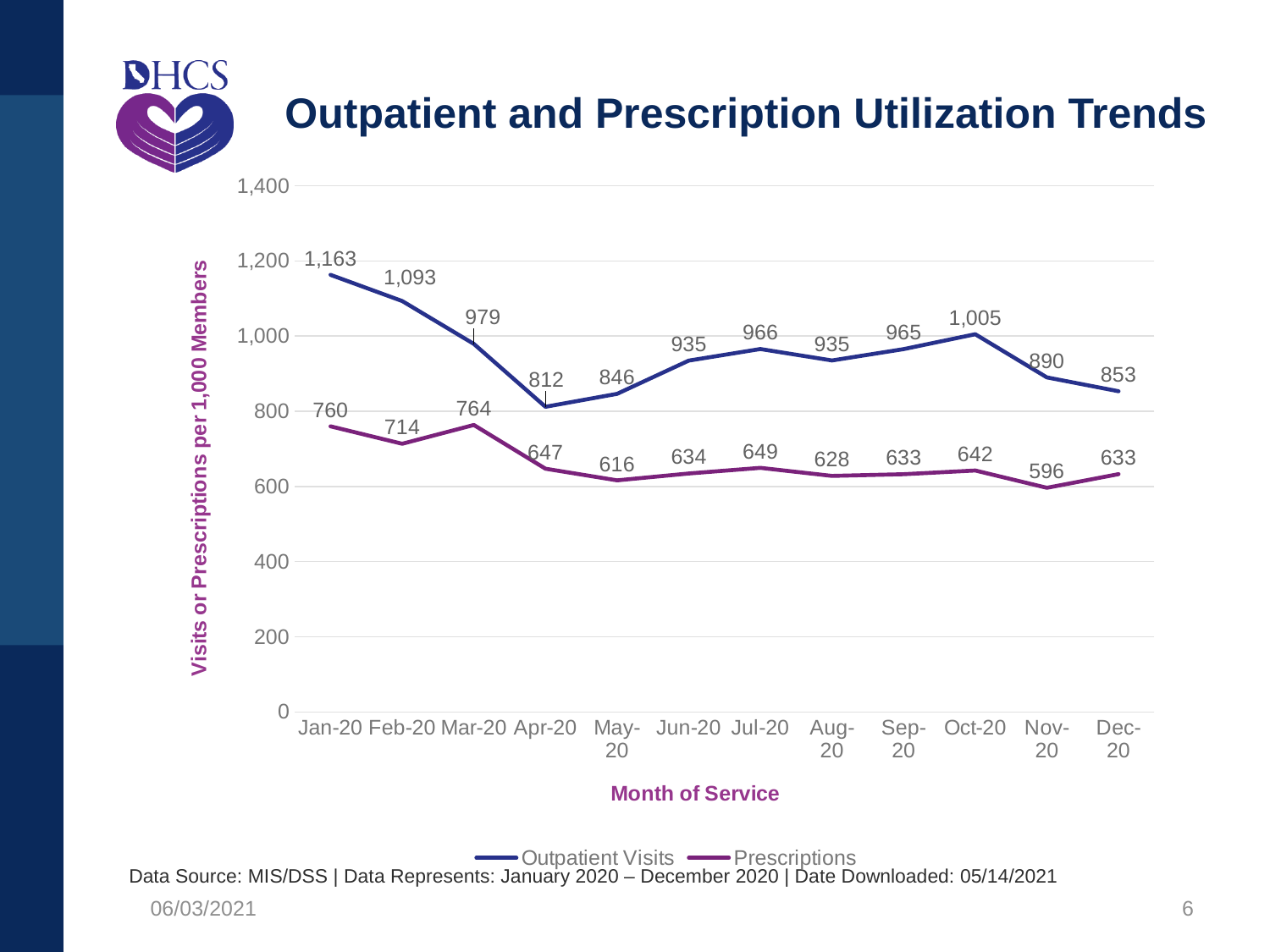
In which month is the Prescriptions value highest? Mar-20 How many series does the legend list? 2 What is the title of the chart? Outpatient and Prescription Utilization Trends What kind of chart is shown? Line chart What is the value for Outpatient Visits in Jan-20? 1,163 Which is larger: Outpatient Visits in Jan-20 or Outpatient Visits in Feb-20? Jan-20 In which month is the Outpatient Visits value lowest? Apr-20 How many months are plotted on the x axis? 12 Do Outpatient Visits rise or fall from Jan-20 to Apr-20? Fall What is the value for Outpatient Visits in Oct-20? 1,005 What is the value for Prescriptions in Nov-20? 596 What is the difference between Outpatient Visits and Prescriptions in Dec-20? 220